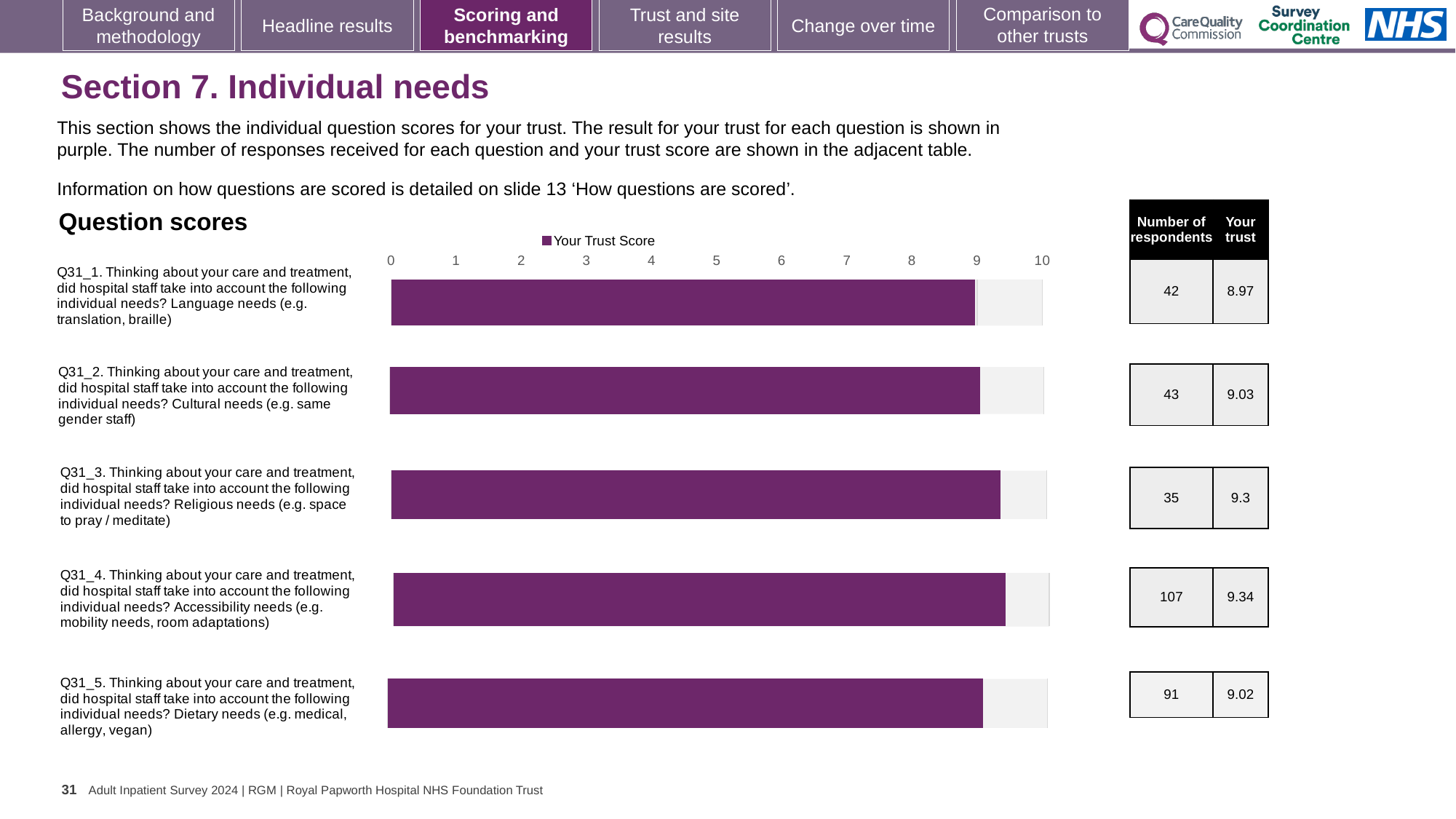
Is the trust score for Q31_1 (Language needs) greater or less than 9? less Which question has the lowest trust score? Q31_1 (Language needs) How many questions are plotted in the Question scores chart? 5 What is the trust score for Q31_3 (Religious needs) shown in the adjacent table? 9.3 What type of chart is used to show the question scores? Bar chart What is the trust score for Q31_4 (Accessibility needs) shown in the adjacent table? 9.34 What is the difference between the trust scores for Q31_4 (Accessibility needs) and Q31_1 (Language needs)? 0.37 How many respondents answered Q31_4 (Accessibility needs)? 107 What is the trust score for Q31_1 (Language needs) shown in the adjacent table? 8.97 Which has the larger trust score, Q31_2 (Cultural needs) or Q31_5 (Dietary needs)? Q31_2 (Cultural needs) What series name is shown in the chart legend? Your Trust Score Which question has the highest trust score? Q31_4 (Accessibility needs)